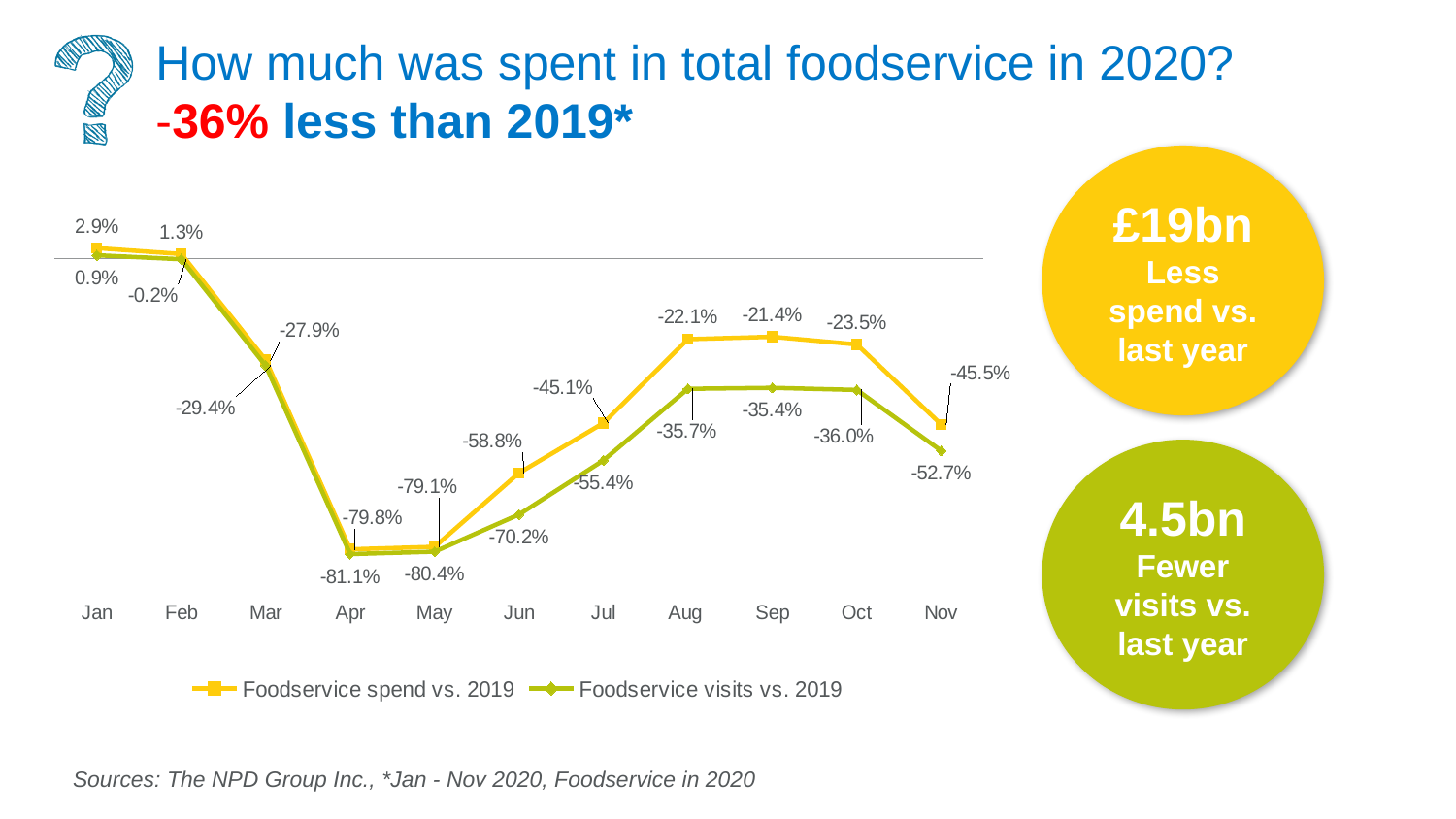
What is the difference between Foodservice spend vs. 2019 and Foodservice visits vs. 2019 in June? 11.4 percentage points In November, which series has the higher value: Foodservice spend vs. 2019 or Foodservice visits vs. 2019? Foodservice spend vs. 2019 In which month is Foodservice visits vs. 2019 at its lowest? Apr What is the value of Foodservice spend vs. 2019 in September? -21.4% Do the values of Foodservice spend vs. 2019 rise or fall from January to April? Fall How many series does the legend list? 2 In which month is Foodservice spend vs. 2019 at its highest? Jan What is the value of Foodservice spend vs. 2019 in April? -79.8% What is the value of Foodservice visits vs. 2019 in June? -70.2% How many months are plotted on the x axis? 11 What type of chart is shown on the slide? Line chart Which colour is used for the Foodservice visits vs. 2019 line? Green